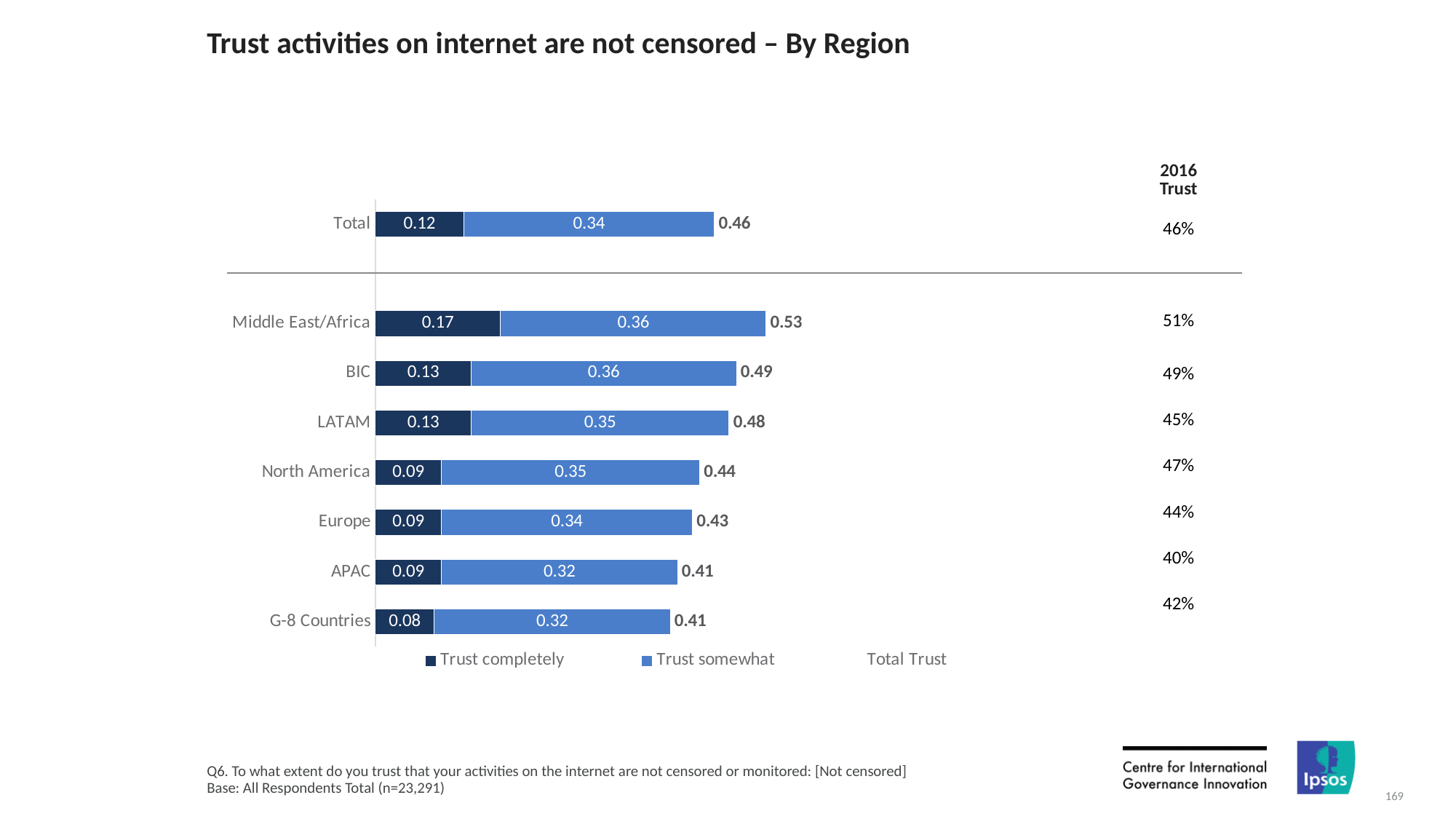
What kind of chart is shown on the slide? Stacked bar chart What is the Total Trust value for LATAM? 0.48 What is the 'Trust somewhat' value for APAC? 0.32 Which has a larger 'Trust somewhat' value, BIC or North America? BIC How many regions are shown below the Total bar? 7 What is the difference between the Total Trust values for Middle East/Africa and Europe? 0.10 How many series does the legend list? 3 What is the 'Trust completely' value for Middle East/Africa? 0.17 Which region has the highest Total Trust value? Middle East/Africa What is the 2016 Trust value shown for APAC? 40% Which region has the lowest 'Trust completely' value? G-8 Countries What is the title of the chart? Trust activities on internet are not censored – By Region